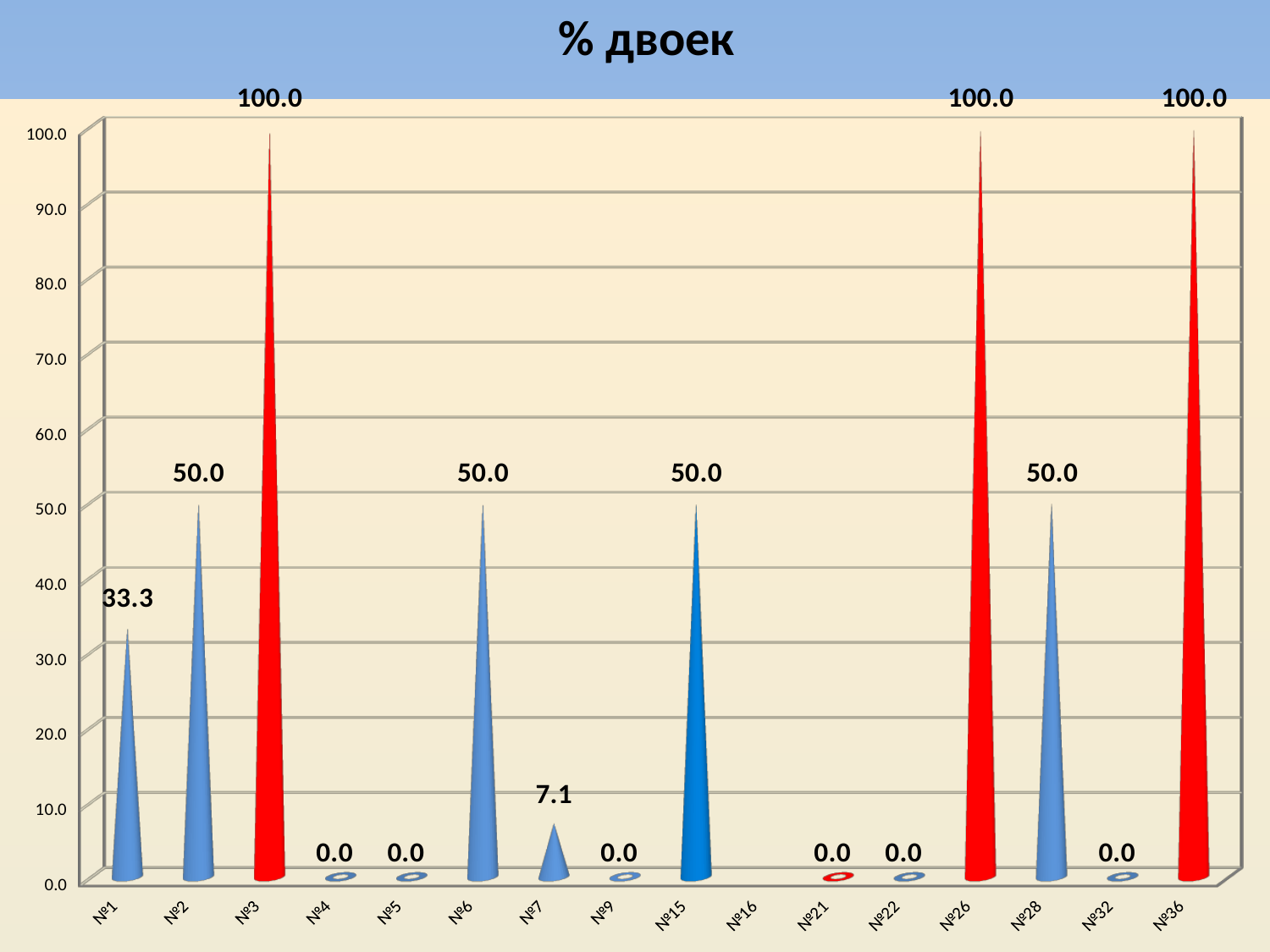
What is the value for №7? 7.1 What is the value for №1? 33.3 What is the title of the chart? % двоек How many categories are shown on the x axis? 16 Which has the larger value, №6 or №36? №36 What kind of chart is shown on the slide? bar chart What is the value for №22? 0.0 What is the value for №28? 50.0 What is the value for №26? 100.0 What is the highest value shown in the chart? 100.0 What is the difference between the values for №1 and №7? 26.2 What is the difference between the values for №3 and №2? 50.0